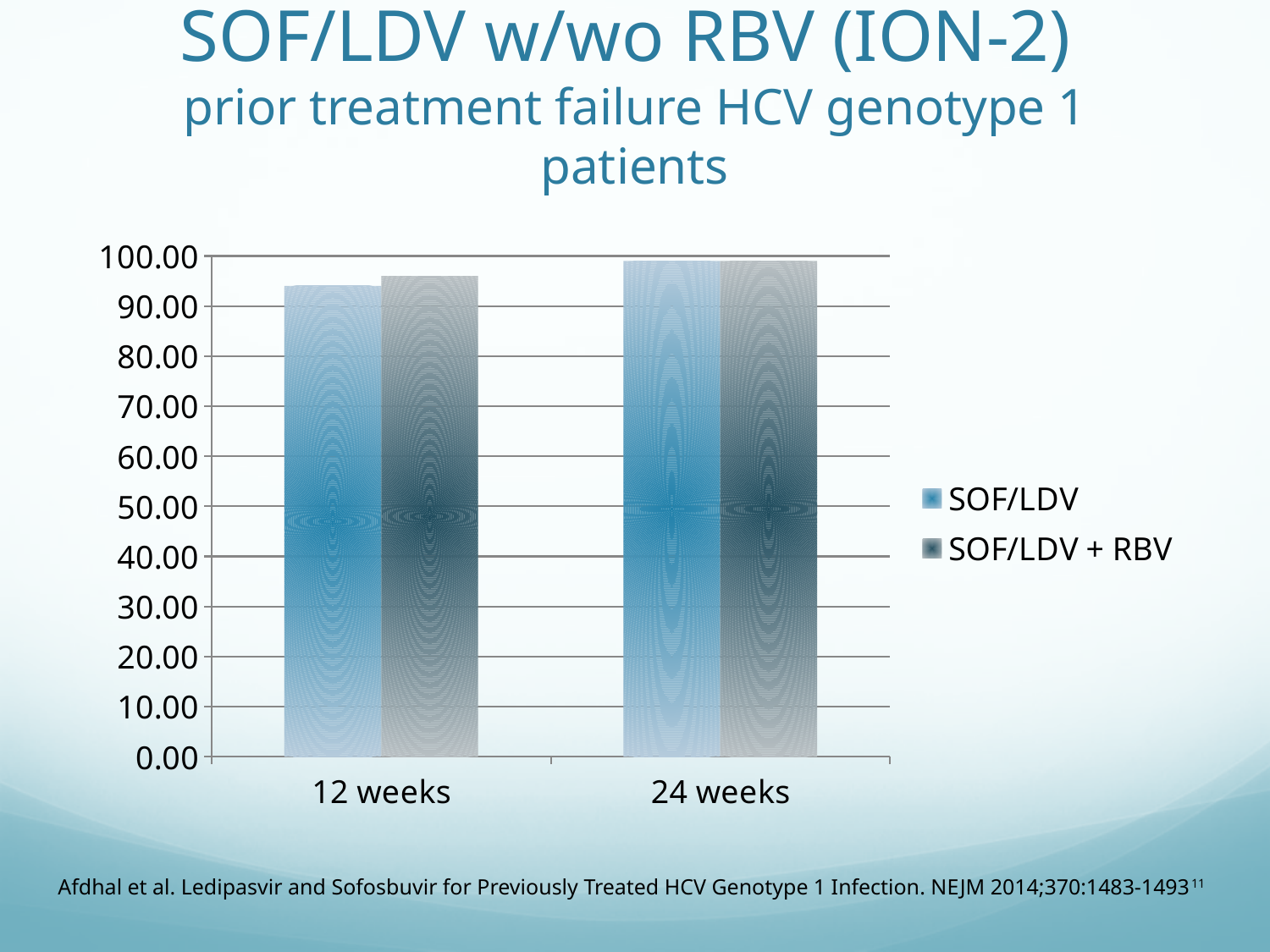
What are the two categories on the x axis? 12 weeks and 24 weeks Is the value for SOF/LDV + RBV at 12 weeks greater or less than 90.00? greater Is the value for SOF/LDV at 24 weeks greater or less than 90.00? greater Which series are listed in the legend? SOF/LDV and SOF/LDV + RBV Is the value for SOF/LDV at 12 weeks greater or less than 90.00? greater At 12 weeks, which is larger: SOF/LDV or SOF/LDV + RBV? SOF/LDV + RBV How many categories are shown on the x axis? 2 What kind of chart is shown on the slide? bar chart Does the value for SOF/LDV rise or fall from 12 weeks to 24 weeks? rise How many series does the legend list? 2